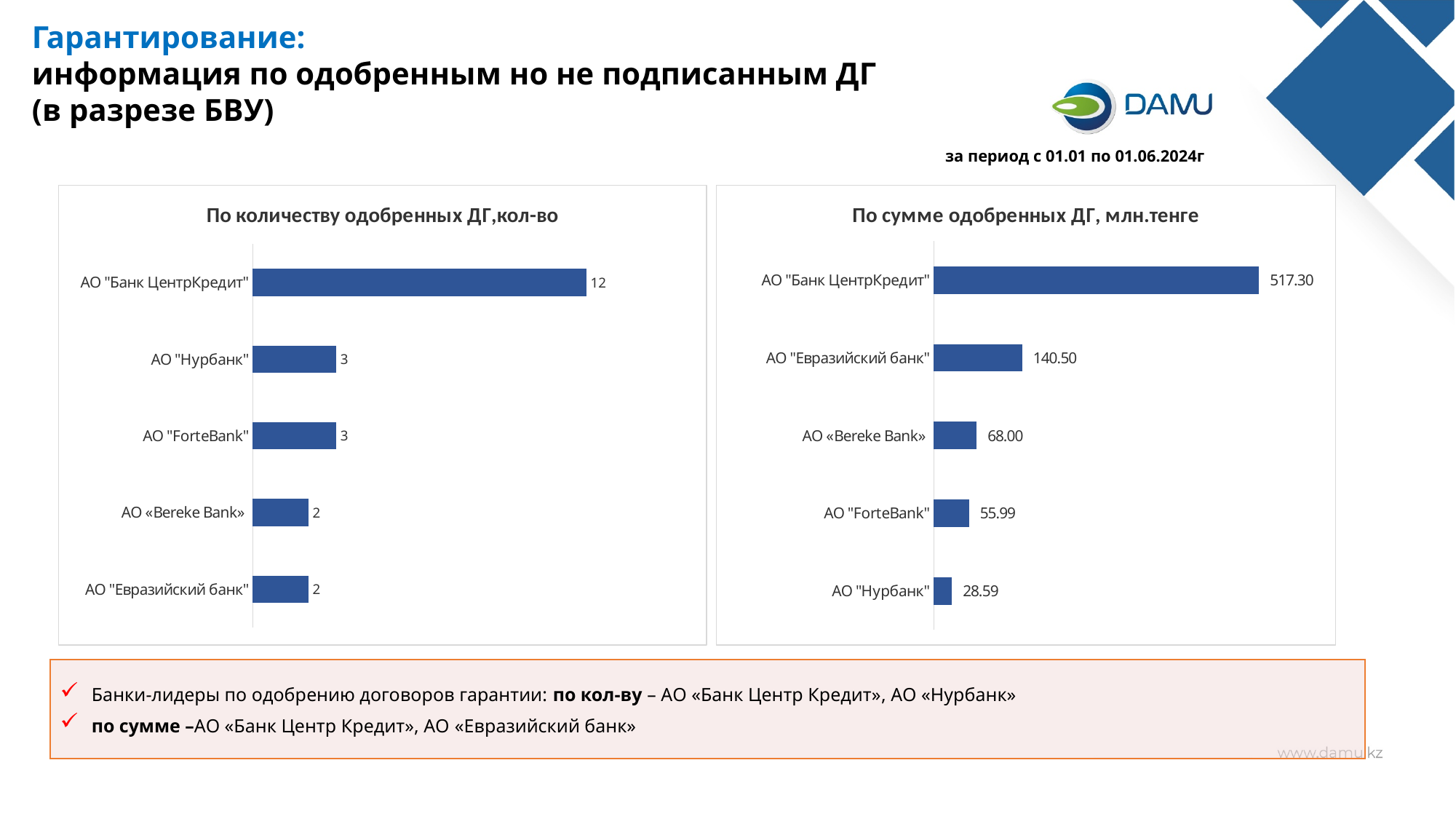
In the chart "По сумме одобренных ДГ, млн.тенге", which bank has the lowest value? АО "Нурбанк" What period is stated on the slide for the data in the charts? за период с 01.01 по 01.06.2024г In the chart "По количеству одобренных ДГ,кол-во", what is the difference between АО "Банк ЦентрКредит" and АО "Нурбанк"? 9 What type of chart is "По сумме одобренных ДГ, млн.тенге"? Bar chart In the chart "По сумме одобренных ДГ, млн.тенге", what is the difference between АО "Банк ЦентрКредит" and АО "Евразийский банк"? 376.80 In the chart "По количеству одобренных ДГ,кол-во", which bank has the highest value? АО "Банк ЦентрКредит" In the chart "По сумме одобренных ДГ, млн.тенге", what is the value for АО "Евразийский банк"? 140.50 In the chart "По количеству одобренных ДГ,кол-во", what is the value for АО "Банк ЦентрКредит"? 12 In the chart "По сумме одобренных ДГ, млн.тенге", which is larger: АО «Bereke Bank» or АО "ForteBank"? АО «Bereke Bank» In the chart "По сумме одобренных ДГ, млн.тенге", what is the value for АО "ForteBank"? 55.99 How many banks are shown in the chart "По количеству одобренных ДГ,кол-во"? 5 In the chart "По сумме одобренных ДГ, млн.тенге", what is the value for АО «Bereke Bank»? 68.00